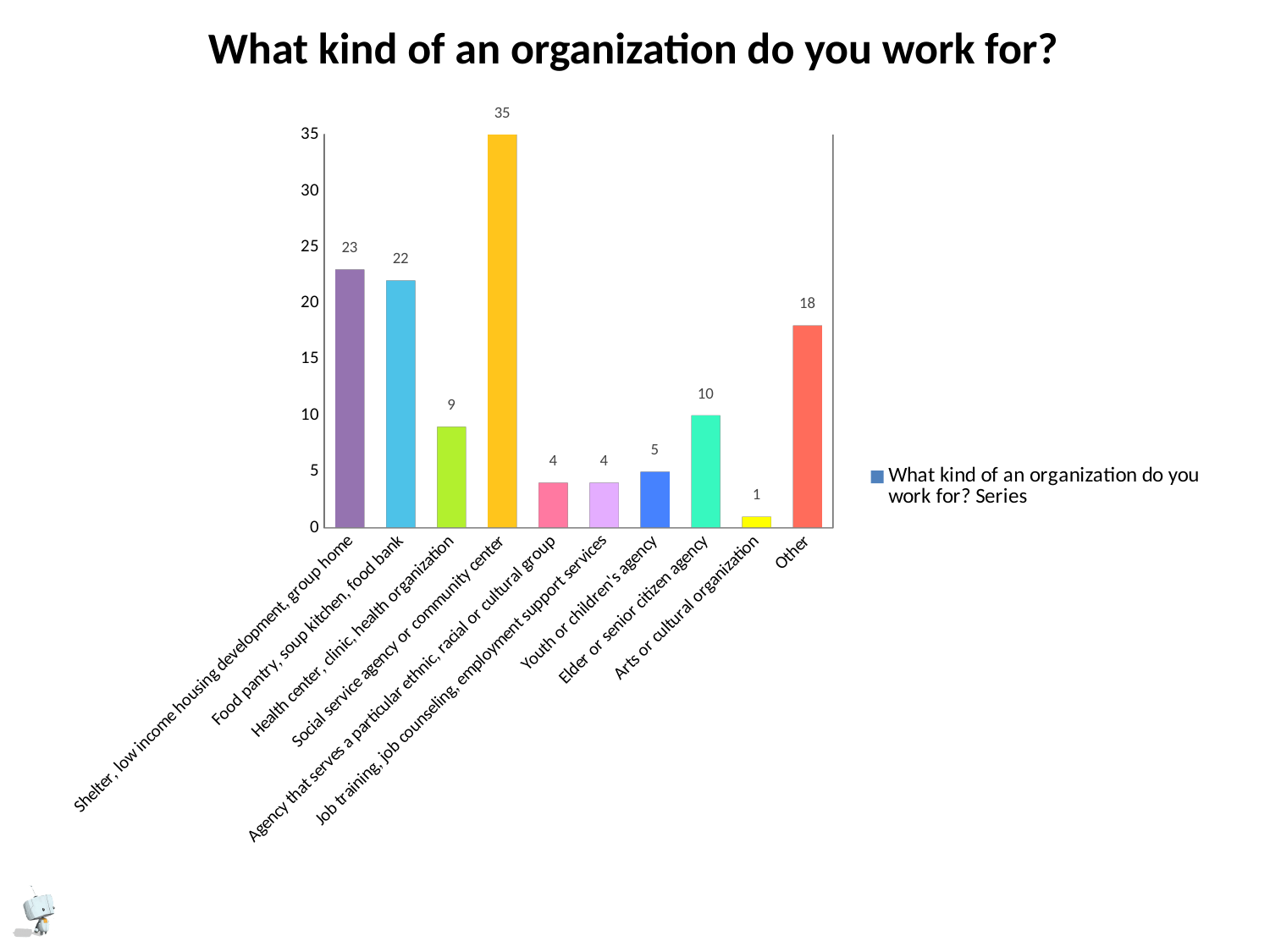
Is the value for Other greater or less than 15? greater What is the value for Elder or senior citizen agency? 10 Which category has the highest value? Social service agency or community center Which is larger, the value for Health center, clinic, health organization or the value for Youth or children's agency? Health center, clinic, health organization What is the title of the chart? What kind of an organization do you work for? What is the value for Other? 18 What is the value for Social service agency or community center? 35 Which category has the lowest value? Arts or cultural organization What is the difference between the values for Social service agency or community center and Other? 17 What kind of chart is shown on the slide? bar chart How many categories are shown on the x axis? 10 What is the difference between the values for Shelter, low income housing development, group home and Food pantry, soup kitchen, food bank? 1